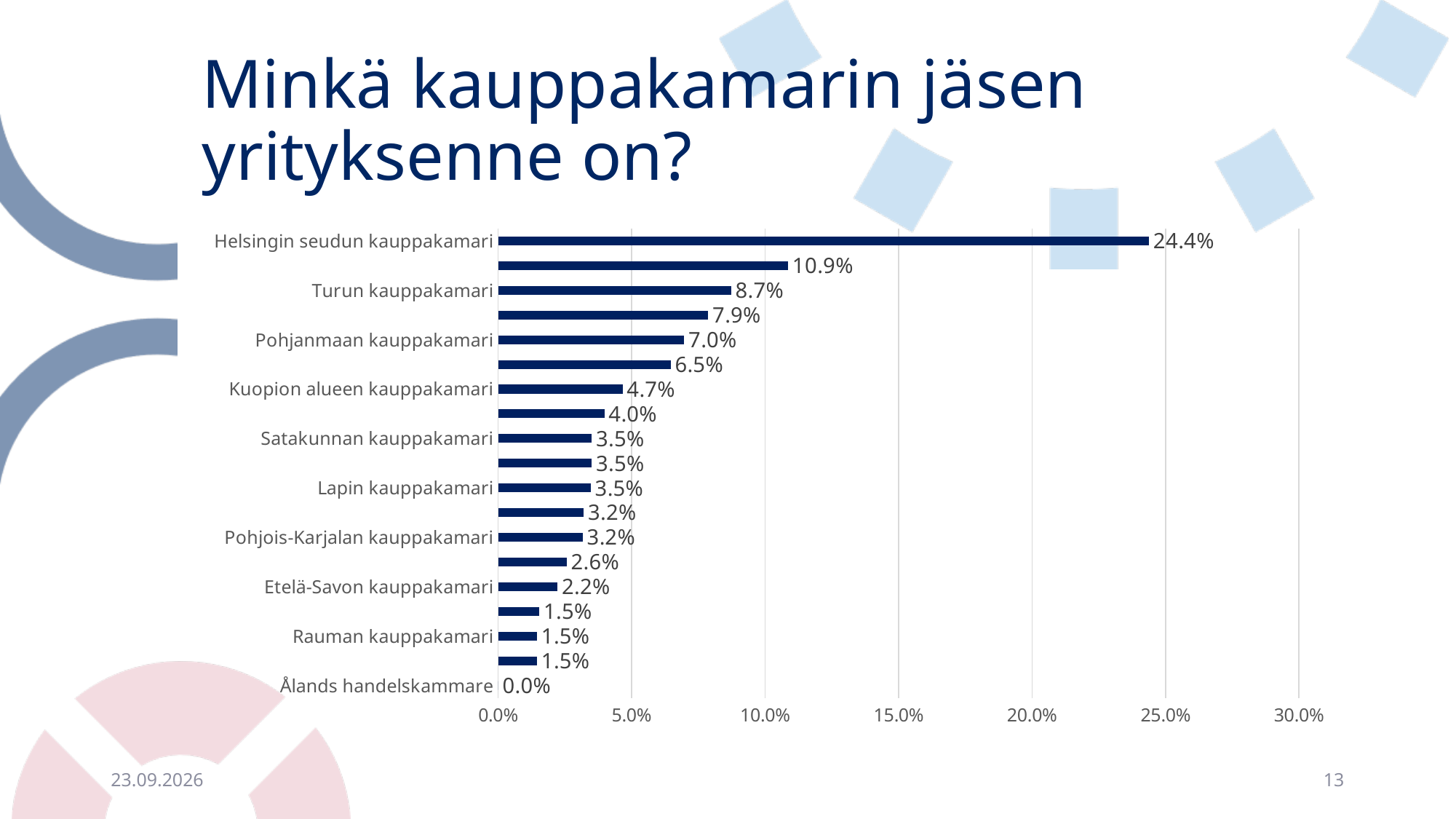
What is the difference between the values for Helsingin seudun kauppakamari and Turun kauppakamari? 15.7% Is the value for Helsingin seudun kauppakamari greater or less than 20.0%? greater What is the value for Helsingin seudun kauppakamari? 24.4% Which category has the lowest value? Ålands handelskammare What is the value for Pohjanmaan kauppakamari? 7.0% Which category has the highest value? Helsingin seudun kauppakamari What is the value for Kuopion alueen kauppakamari? 4.7% What kind of chart is shown on the slide? Bar chart What is the value for Turun kauppakamari? 8.7% How many bars are plotted in the chart? 19 What is the value for Etelä-Savon kauppakamari? 2.2% Which is larger, the value for Pohjanmaan kauppakamari or the value for Kuopion alueen kauppakamari? Pohjanmaan kauppakamari